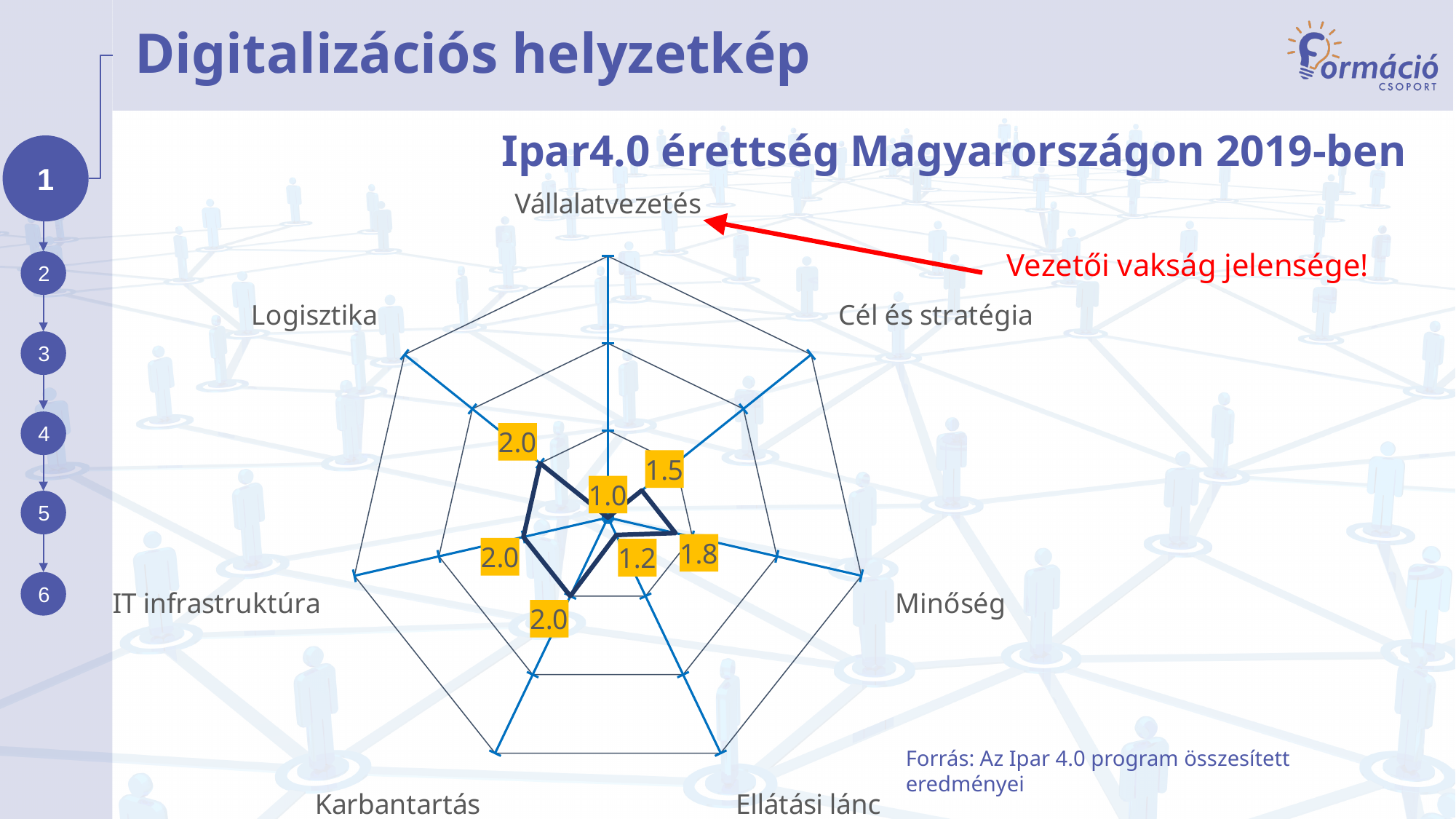
How many categories does the radar chart have? 7 Which is larger, the value for Cél és stratégia or the value for Ellátási lánc? Cél és stratégia How many categories have a value of 2.0? 3 What is the value for Karbantartás? 2.0 What is the title of the chart? Ipar4.0 érettség Magyarországon 2019-ben What kind of chart is shown on the slide? Radar chart What is the value for Cél és stratégia? 1.5 What is the difference between the values for Minőség and Vállalatvezetés? 0.8 What is the value for Ellátási lánc? 1.2 What is the value for Minőség? 1.8 What is the value for Vállalatvezetés? 1.0 Which category has the lowest value? Vállalatvezetés